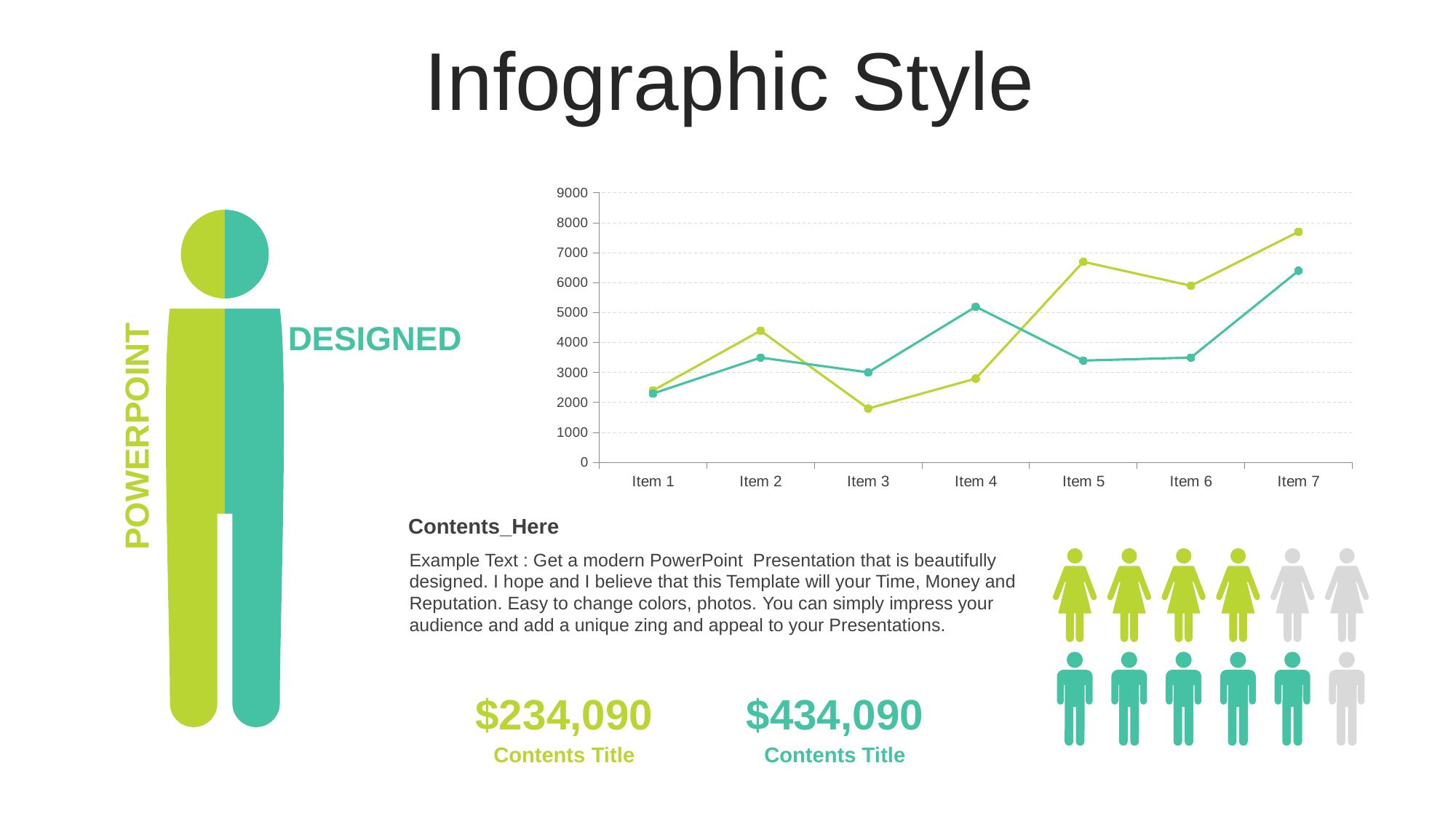
What kind of chart is shown on the slide? line chart Is the value of the green line at Item 7 greater or less than 7000? greater At which item does the green line reach its lowest value? Item 3 At Item 4, which line has the higher value, the green line or the teal line? the teal line How many lines are plotted on the line chart? 2 At which item does the green line reach its highest value? Item 7 Between Item 2 and Item 3, does the green line rise or fall? fall At Item 5, which line has the higher value, the green line or the teal line? the green line Is the value of the green line at Item 3 greater or less than 2000? less Is the value of the teal line at Item 1 greater or less than 3000? less How many categories are shown on the x axis of the line chart? 7